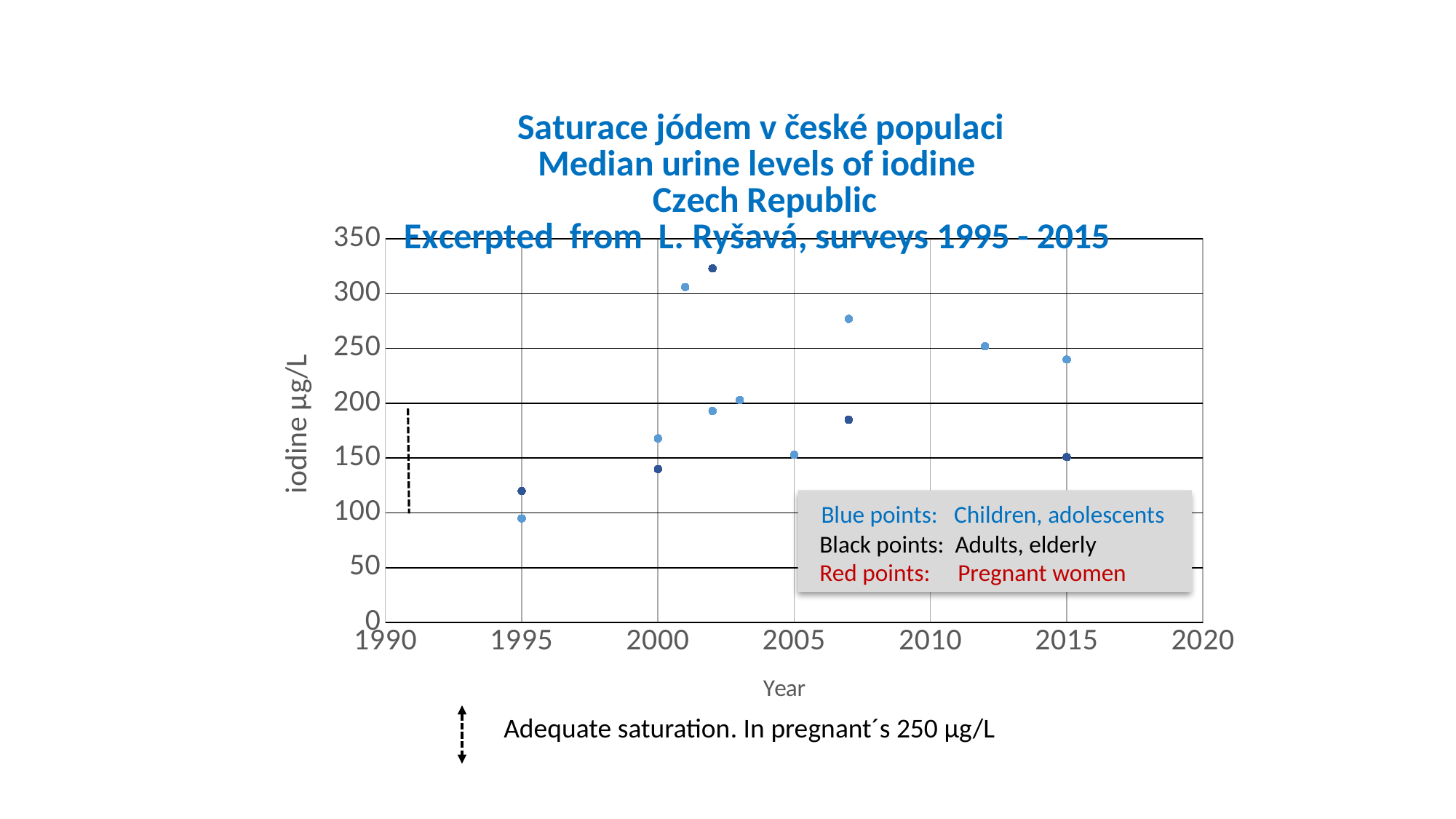
Is the higher of the two points plotted for 2015 greater or less than 250? less How many groups does the legend box list? 3 According to the legend, what do the blue points represent? Children, adolescents Is the higher of the two points plotted for 1995 greater or less than 100? greater In which year is the lowest point on the chart plotted? 1995 What kind of chart is shown on the slide? scatter chart What does the y axis of the chart measure? iodine µg/L Is the highest value plotted for 2002 greater or less than 300? greater Which is larger: the highest point plotted for 2002 or the highest point plotted for 2012? 2002 In which year is the highest point on the chart plotted? 2002